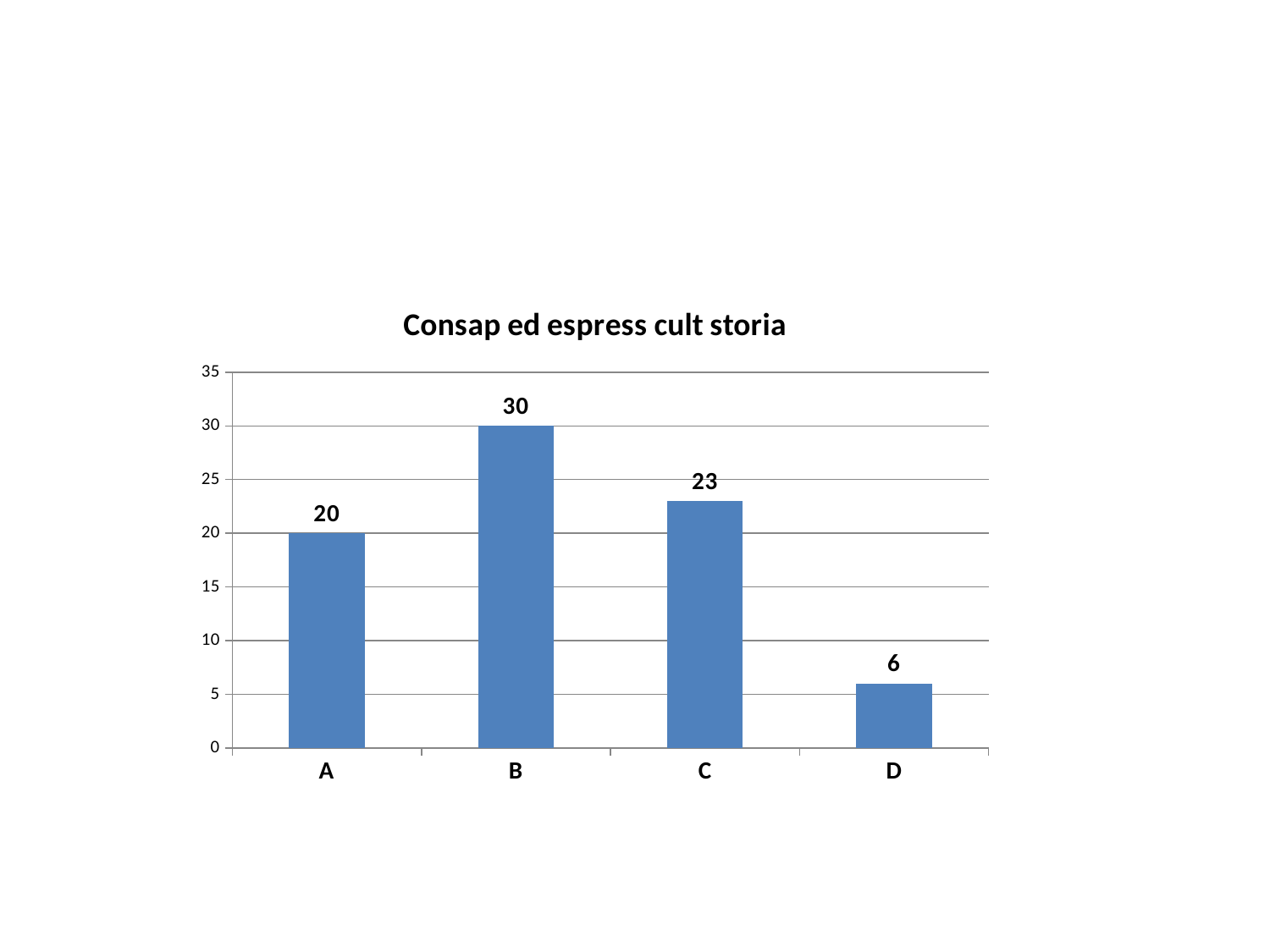
Which category has the lowest value? D What is the value for category D? 6 What is the value for category B? 30 How many categories are shown on the x axis? 4 Which category has the highest value? B What is the value for category A? 20 What kind of chart is shown on the slide? Bar chart What is the difference between the values for B and C? 7 What is the value for category C? 23 What is the title of the chart? Consap ed espress cult storia What is the difference between the values for A and D? 14 Which is larger, the value for A or the value for C? C